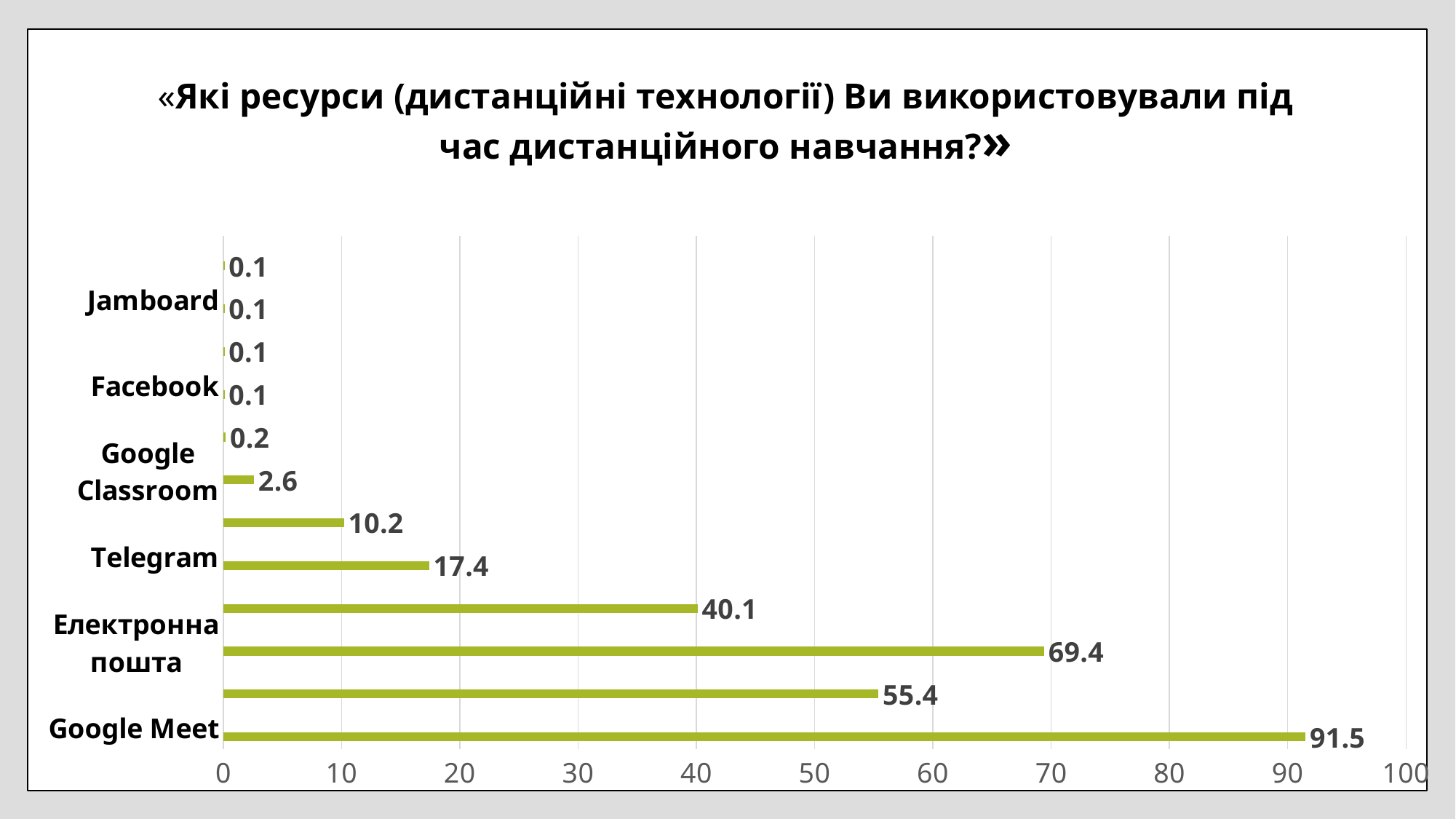
What value is shown for Google Meet? 91.5 Which has a larger value, Telegram or Google Classroom? Telegram What value is shown for Google Classroom? 2.6 Is the value for Електронна пошта greater or less than 60? greater What value is shown for Електронна пошта? 69.4 What is the difference between the values for Google Meet and Електронна пошта? 22.1 What kind of chart is shown on the slide? Bar chart How many bars are plotted in the chart? 12 Which labeled category has the highest value? Google Meet What is the title of the chart? «Які ресурси (дистанційні технології) Ви використовували під час дистанційного навчання?» What is the difference between the values for Telegram and Google Classroom? 14.8 What value is shown for Telegram? 17.4